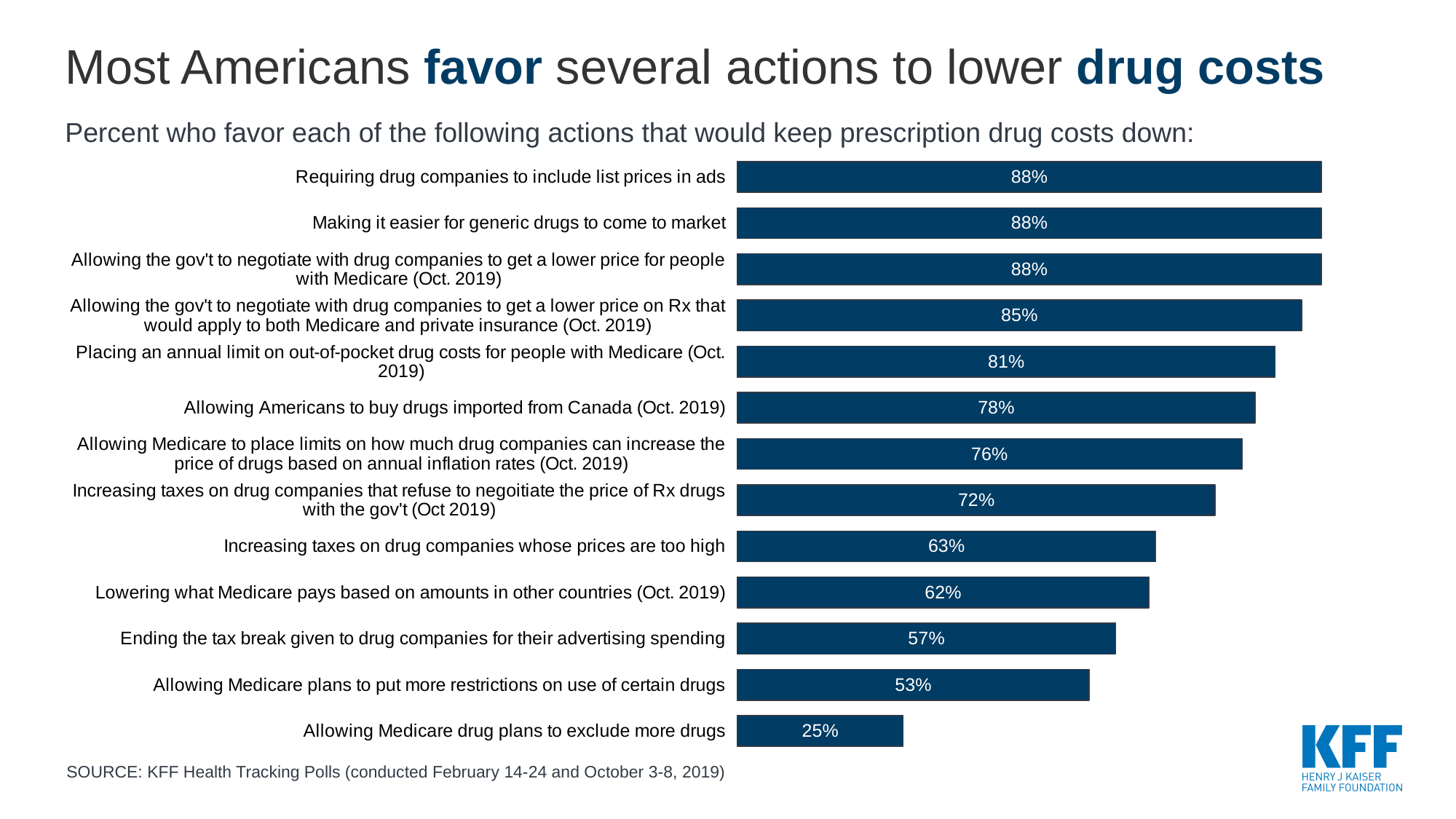
What percent favor allowing Americans to buy drugs imported from Canada? 78% How many actions are shown on the chart? 13 What percent favor placing an annual limit on out-of-pocket drug costs for people with Medicare? 81% What is the source of the data shown on the slide? KFF Health Tracking Polls (conducted February 14-24 and October 3-8, 2019) Which action has the lowest percent in favor? Allowing Medicare drug plans to exclude more drugs How many actions have exactly 88% in favor? 3 What is the difference between the percent favoring making it easier for generic drugs to come to market and the percent favoring increasing taxes on drug companies whose prices are too high? 25% What is the highest percent shown on the chart? 88% Which has a higher percent in favor: lowering what Medicare pays based on amounts in other countries, or increasing taxes on drug companies that refuse to negotiate the price of Rx drugs with the gov't? Increasing taxes on drug companies that refuse to negotiate the price of Rx drugs with the gov't What kind of chart is shown on the slide? Bar chart What is the difference between the percent favoring allowing Medicare plans to put more restrictions on use of certain drugs and the percent favoring allowing Medicare drug plans to exclude more drugs? 28% What percent favor ending the tax break given to drug companies for their advertising spending? 57%